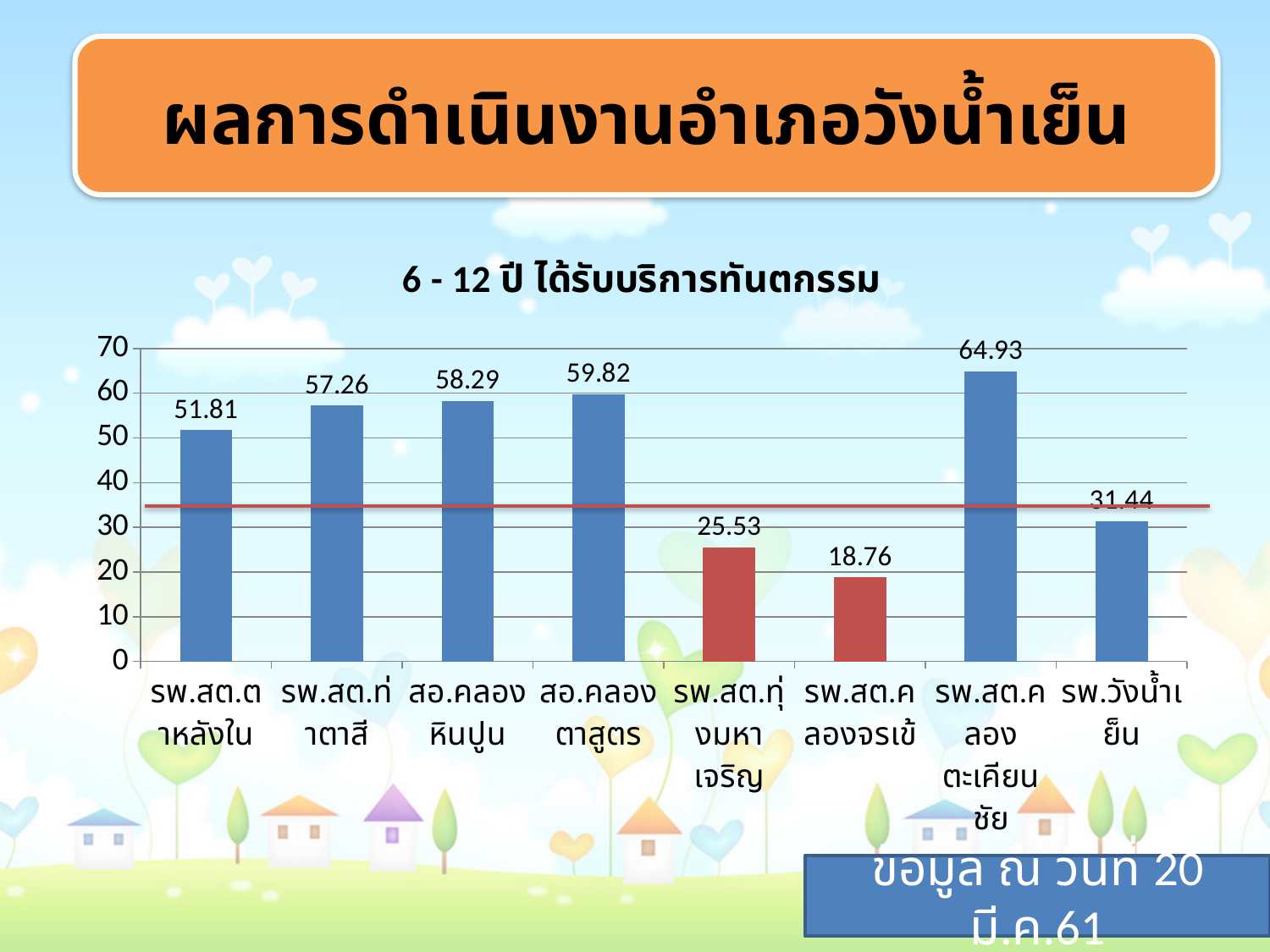
Which category has the lowest value? รพ.สต.คลองจรเข้ Is the value for รพ.สต.ท่าตาสี greater or less than 50? greater What is the difference between the values for รพ.สต.คลองตะเคียนชัย and รพ.สต.คลองจรเข้? 46.17 What is the title of the chart? 6 - 12 ปี ได้รับบริการทันตกรรม What kind of chart is shown on the slide? bar chart Which is larger, the value for รพ.สต.ทุ่งมหาเจริญ or the value for รพ.วังน้ำเย็น? รพ.วังน้ำเย็น What is the value for รพ.สต.คลองจรเข้? 18.76 How many categories are shown on the x axis? 8 What is the difference between the values for สอ.คลองตาสูตร and สอ.คลองหินปูน? 1.53 Which category has the highest value? รพ.สต.คลองตะเคียนชัย What is the value for รพ.สต.ตาหลังใน? 51.81 What is the value for รพ.วังน้ำเย็น? 31.44